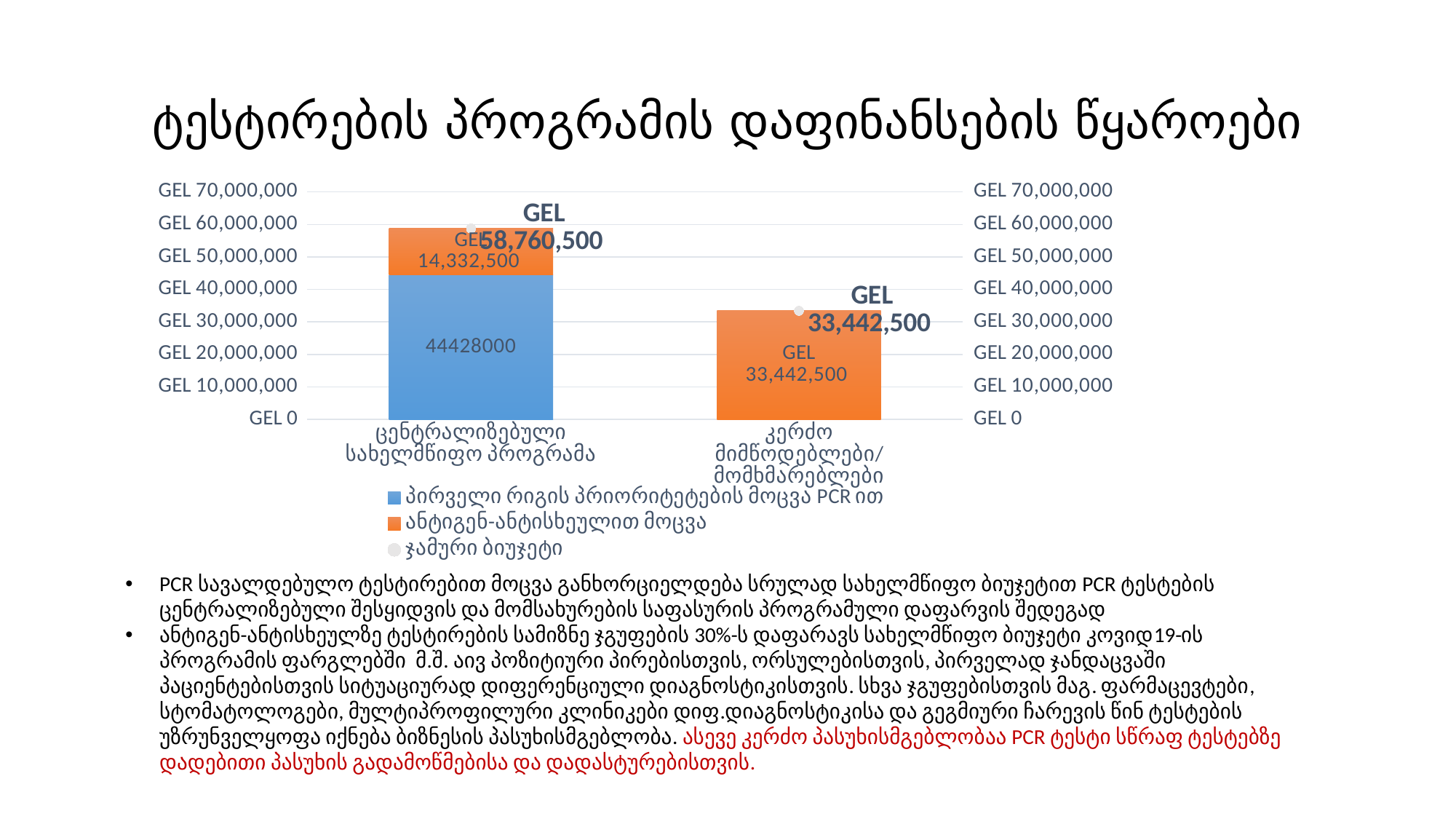
What is the value of პირველი რიგის პრიორიტეტების მოცვა PCR ით for ცენტრალიზებული სახელმწიფო პროგრამა? 44428000 How many categories are shown on the x axis of the chart? 2 Which colour represents the series ანტიგენ-ანტისხეულით მოცვა in the chart? orange How many series does the chart legend list? 3 What is the value of ანტიგენ-ანტისხეულით მოცვა for ცენტრალიზებული სახელმწიფო პროგრამა? GEL 14,332,500 What is the title of the chart? ტესტირების პროგრამის დაფინანსების წყაროები Which category has the higher total budget? ცენტრალიზებული სახელმწიფო პროგრამა What is the total budget (ჯამური ბიუჯეტი) for კერძო მიმწოდებლები/მომხმარებლები? GEL 33,442,500 Is the total budget for კერძო მიმწოდებლები/მომხმარებლები greater or less than GEL 40,000,000? less What is the difference between the total budgets of ცენტრალიზებული სახელმწიფო პროგრამა and კერძო მიმწოდებლები/მომხმარებლები? GEL 25,318,000 What type of chart is shown on the slide? stacked bar chart What is the total budget (ჯამური ბიუჯეტი) for ცენტრალიზებული სახელმწიფო პროგრამა? GEL 58,760,500